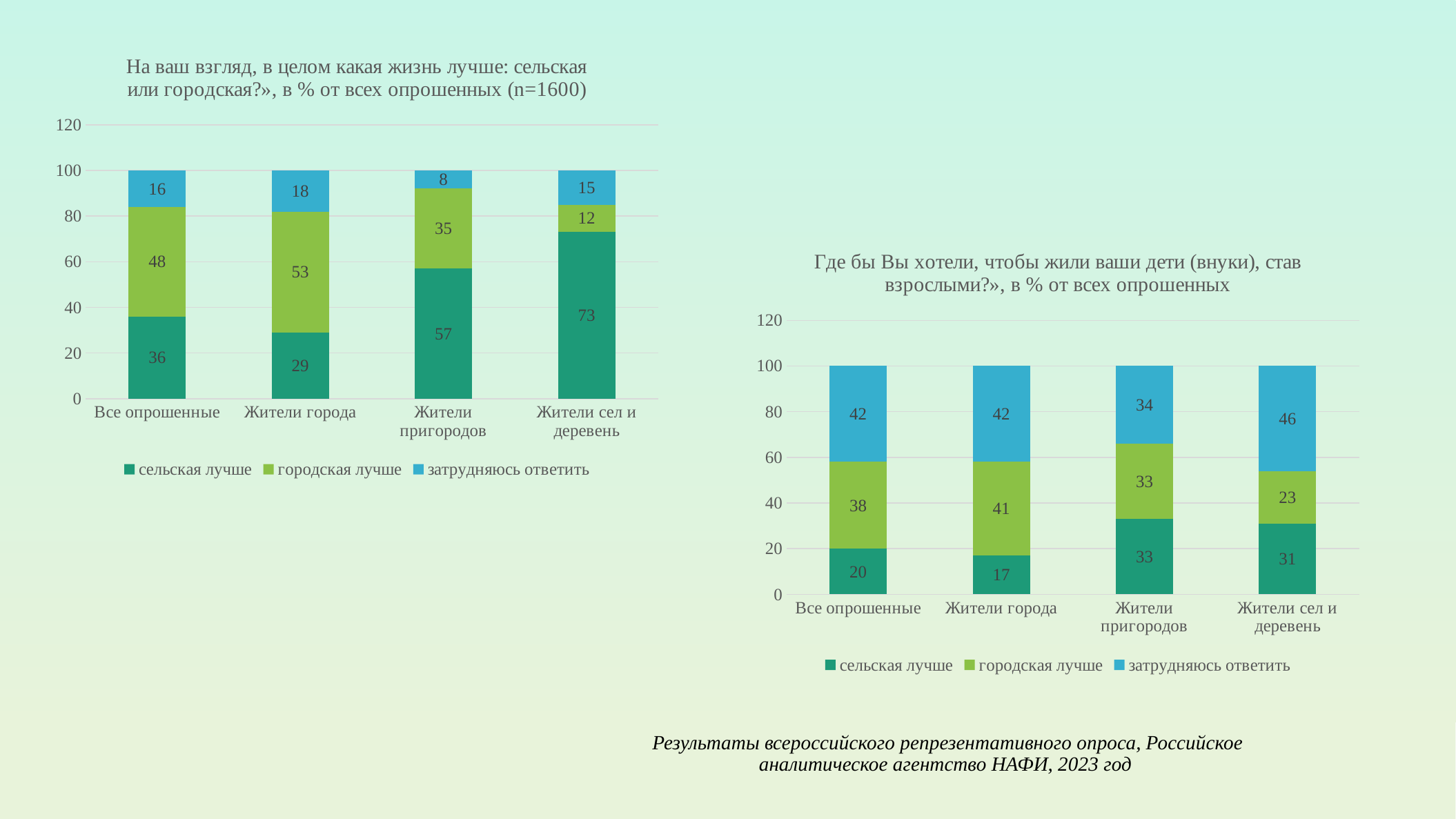
What type of chart is the left chart? Stacked bar chart In the left chart, what is the total of the stacked bar for 'Все опрошенные'? 100 How many series does the legend of the right chart list? 3 In the right chart, which category has the lowest value for 'городская лучше'? Жители сел и деревень In the left chart, which category has the lowest value for 'затрудняюсь ответить'? Жители пригородов In the right chart, what is the value of 'затрудняюсь ответить' for 'Жители сел и деревень'? 46 In the left chart, what is the value of 'городская лучше' for 'Жители города'? 53 In the left chart, which category has the highest value for 'сельская лучше'? Жители сел и деревень In the left chart, what is the value of 'сельская лучше' for 'Жители сел и деревень'? 73 In the right chart, which is larger: 'городская лучше' for 'Все опрошенные' or for 'Жители города'? Жители города In the left chart, what is the difference between 'сельская лучше' for 'Жители пригородов' and for 'Жители города'? 28 In the right chart, what is the value of 'сельская лучше' for 'Жители города'? 17